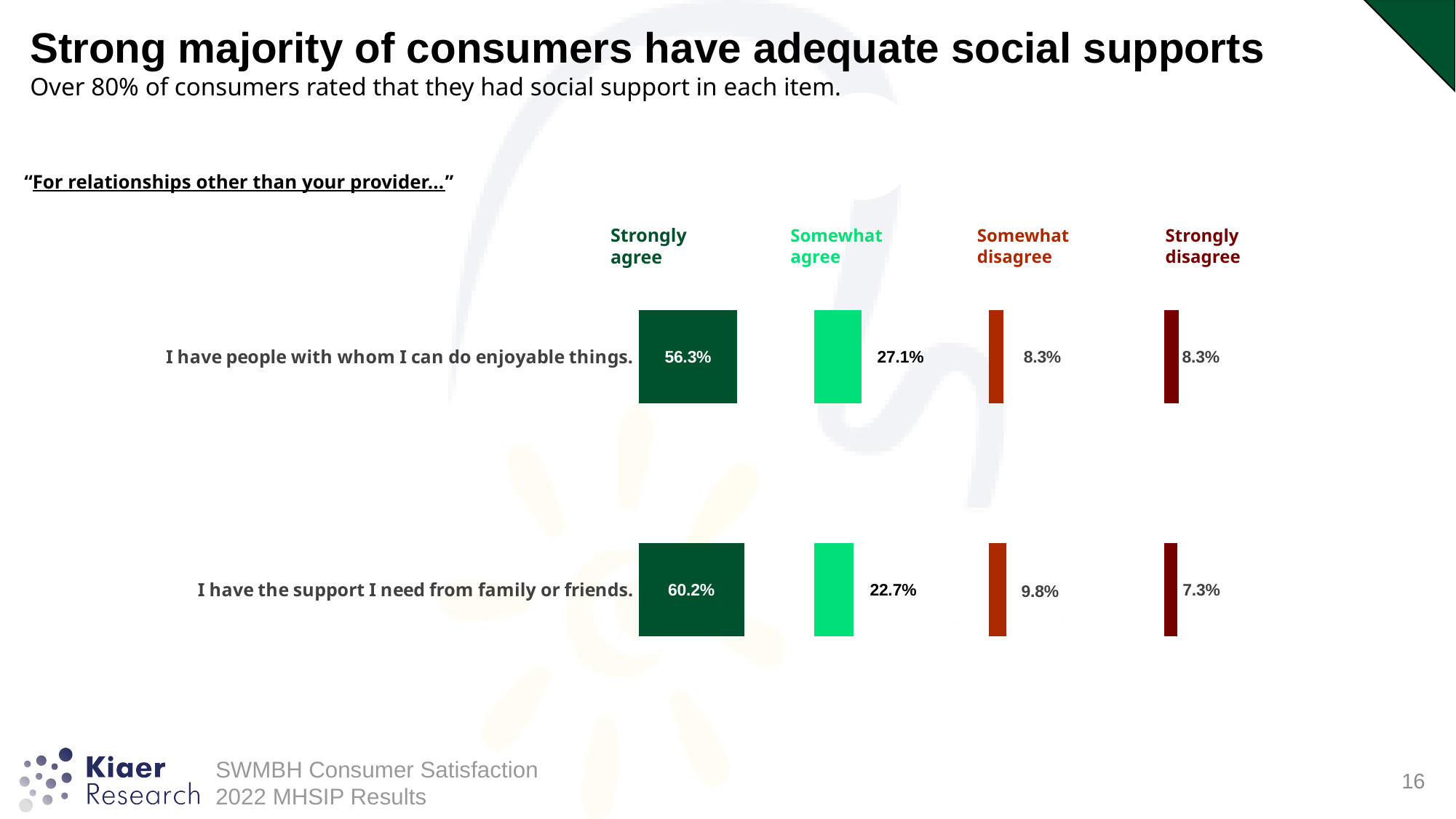
What percentage of consumers strongly disagree that they have people with whom they can do enjoyable things? 8.3% How many survey items are shown in the chart? 2 How many response categories are shown across the top of the chart? 4 What percentage of consumers somewhat disagree that they have the support they need from family or friends? 9.8% What percentage of consumers strongly agree that they have people with whom they can do enjoyable things? 56.3% For the item 'I have the support I need from family or friends', which response category has the lowest percentage? Strongly disagree How many percentage points higher is the 'Strongly agree' value for 'I have the support I need from family or friends' than for 'I have people with whom I can do enjoyable things'? 3.9 What type of chart is used on this slide? Bar chart For the item 'I have the support I need from family or friends', which response category has the highest percentage? Strongly agree What is the combined percentage of 'Strongly agree' and 'Somewhat agree' for 'I have people with whom I can do enjoyable things'? 83.4% Which item has the larger 'Somewhat agree' percentage: 'I have people with whom I can do enjoyable things' or 'I have the support I need from family or friends'? I have people with whom I can do enjoyable things. What percentage of consumers somewhat agree that they have the support they need from family or friends? 22.7%